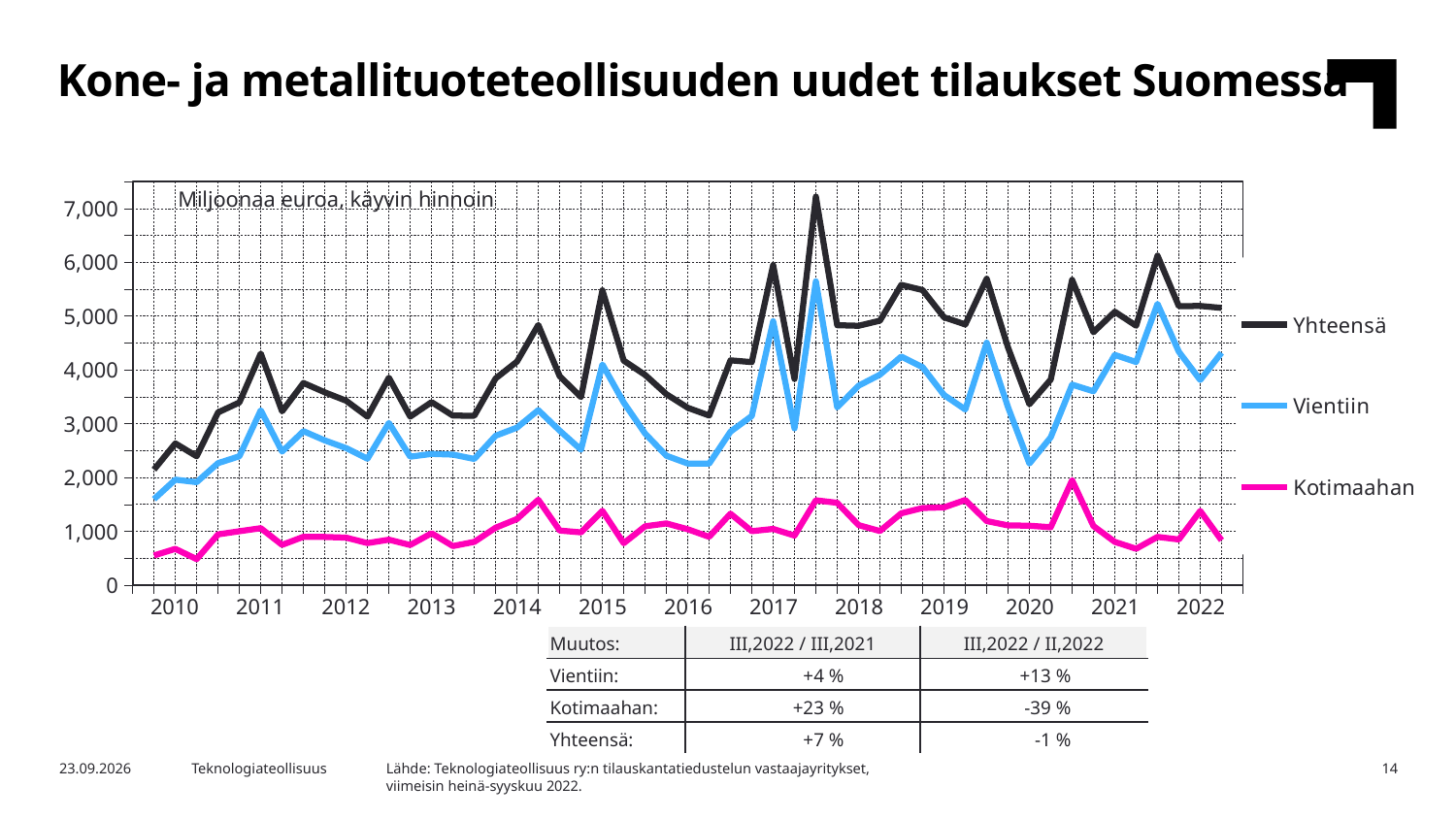
Is the first value of Kotimaahan in 2010 greater or less than 1,000? less How many year labels are shown on the x axis? 13 Which series is larger in 2022, Vientiin or Kotimaahan? Vientiin Which series has the lowest values throughout the chart? Kotimaahan Is the peak value of Vientiin in 2017 greater or less than 5,000? greater How many series does the chart legend list? 3 What unit is stated inside the chart area? Miljoonaa euroa, käyvin hinnoin Is the first value of Vientiin in 2010 greater or less than 2,000? less Which series has the highest values throughout the chart? Yhteensä Which series is shown with the black line in the chart? Yhteensä What kind of chart is shown on the slide? line chart